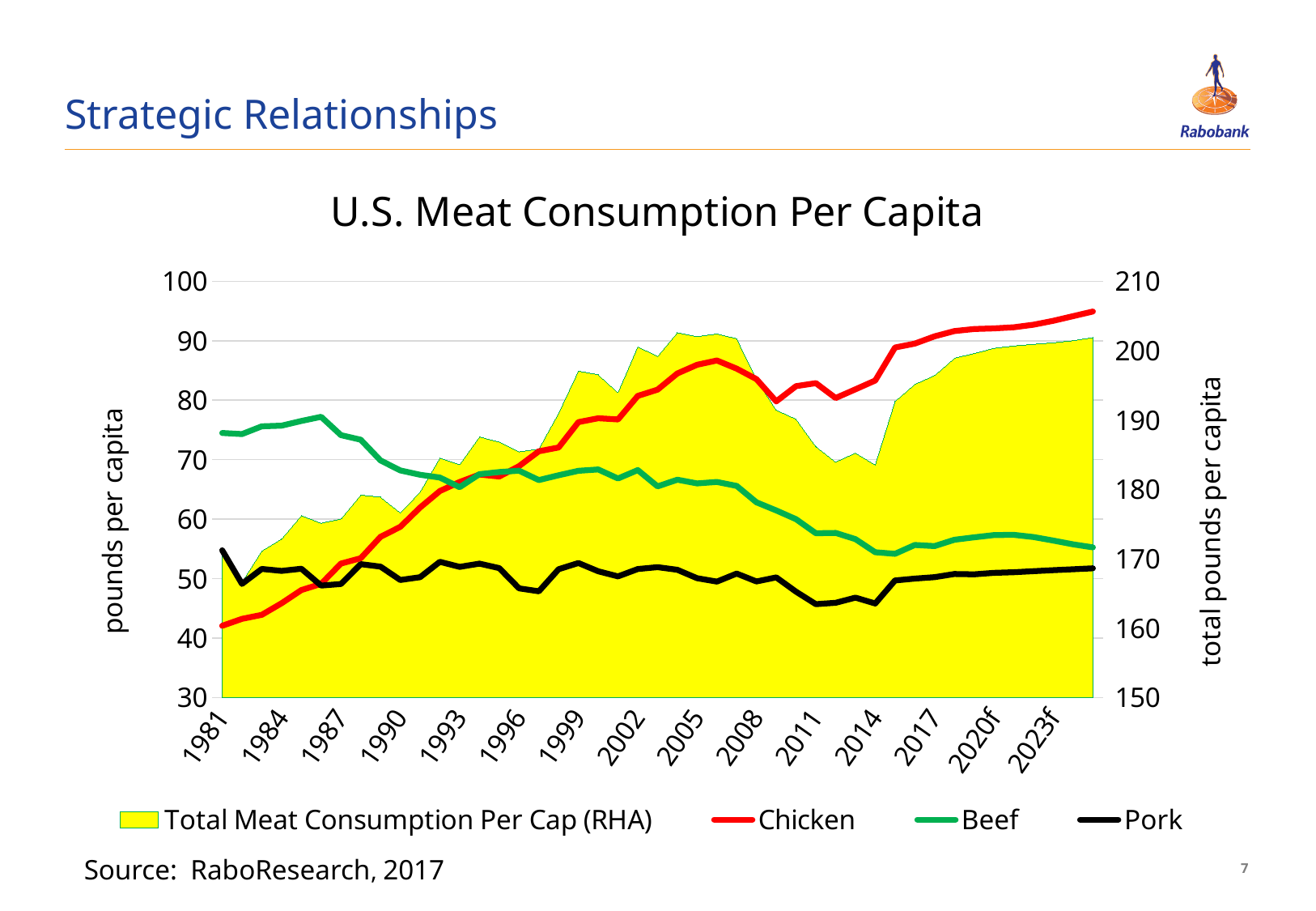
What is the label of the right-hand vertical axis? total pounds per capita Is the value for Chicken in 1981 greater or less than 50? less In 2023f, which is larger, Chicken or Pork? Chicken Is the value for Beef in 1981 greater or less than 70? greater Does the Beef series rise or fall from 1981 to 2023f? fall Does the Chicken series rise or fall from 1981 to 2023f? rise How many series does the chart legend list? 4 In 1981, which is larger, Beef or Chicken? Beef What is the title of the chart? U.S. Meat Consumption Per Capita Is the value for Chicken in 2023f greater or less than 90? greater What kind of chart is shown on the slide? combination area and line chart